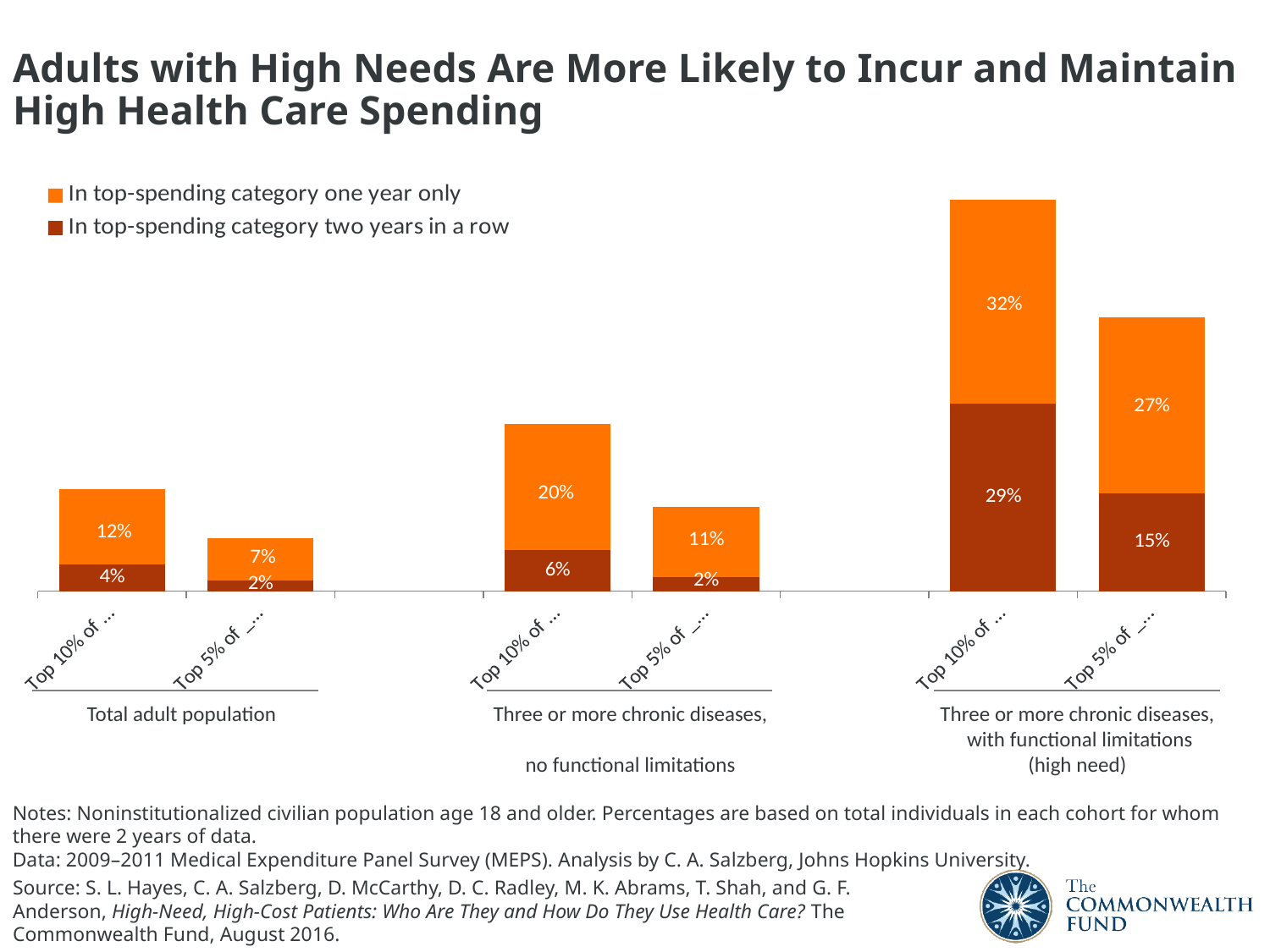
How many series does the legend list? 2 What kind of chart is shown on the slide? Stacked bar chart What is the difference between the 'one year only' value for the Top 10% bar in the high need group (32%) and the Top 10% bar in the Total adult population group (12%)? 20 percentage points In the 'Three or more chronic diseases, no functional limitations' group, what is the value for 'In top-spending category two years in a row' for the Top 5% bar? 2% In the 'Total adult population' group, what is the value for 'In top-spending category one year only' for the Top 10% bar? 12% What is the total of the stacked Top 5% bar in the 'Total adult population' group? 9% How many stacked bars are plotted in the chart? 6 What is the total of the stacked Top 10% bar in the 'Three or more chronic diseases, no functional limitations' group? 26% Which is larger: the 'one year only' value for the Top 10% bar in the 'no functional limitations' group, or the 'one year only' value for the Top 5% bar in the high need group? Top 5% bar in the high need group (27%) Which population group has the highest 'In top-spending category two years in a row' value for its Top 10% bar? Three or more chronic diseases, with functional limitations (high need) What is the total of the stacked Top 10% bar in the 'Three or more chronic diseases, with functional limitations (high need)' group? 61% In the 'Three or more chronic diseases, with functional limitations (high need)' group, what is the value for 'In top-spending category two years in a row' for the Top 10% bar? 29%